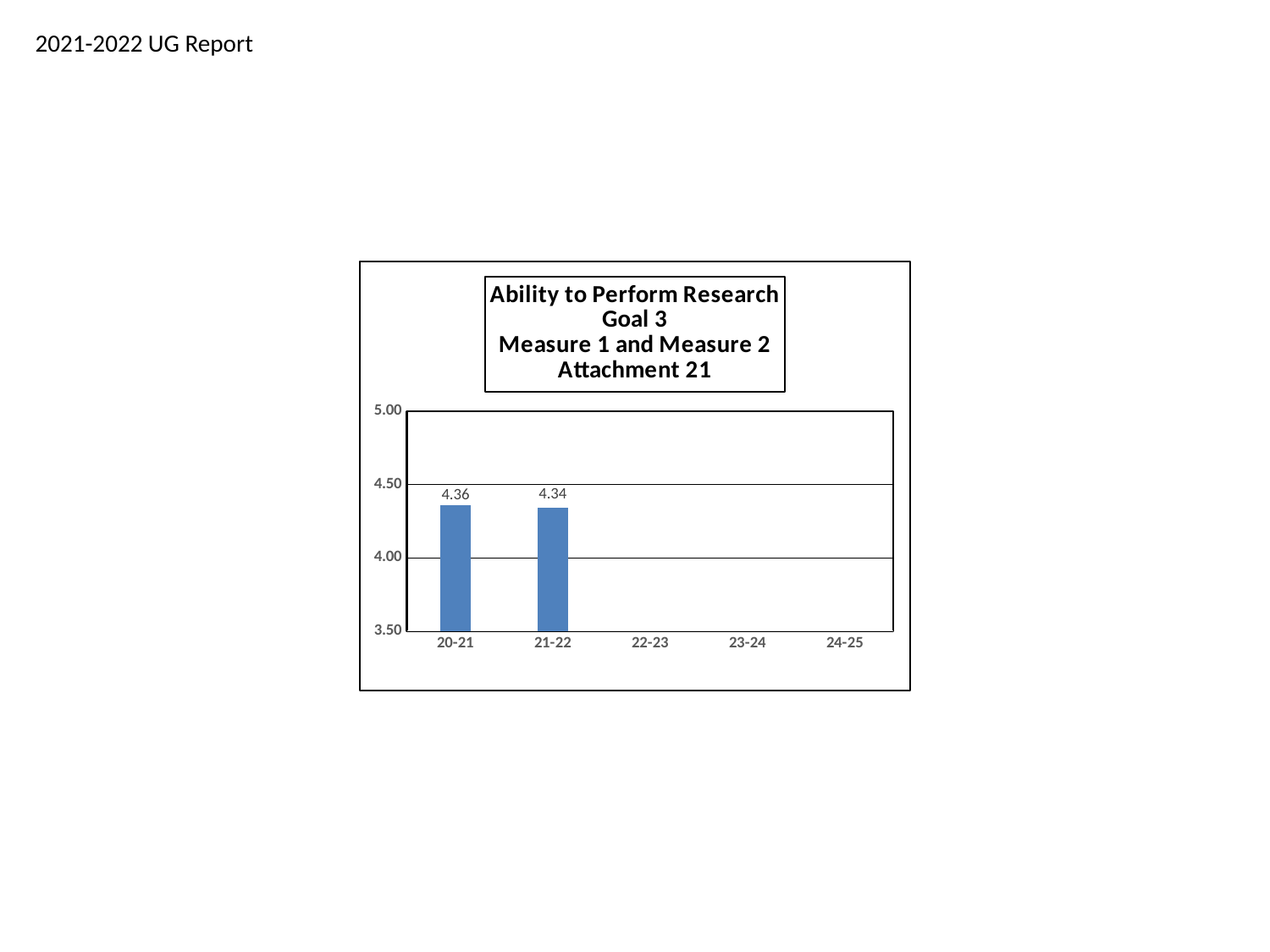
What is the difference between the values for 20-21 and 21-22? 0.02 Do the values rise or fall from 20-21 to 21-22? fall Which is larger, the value for 20-21 or the value for 21-22? 20-21 How many categories are shown on the x axis? 5 What is the value for 21-22? 4.34 Is the value for 21-22 greater or less than 4.00? greater Is the value for 20-21 greater or less than 4.50? less Which category has the highest value? 20-21 How many categories have a plotted bar? 2 What is the value for 20-21? 4.36 What is the first line of the chart title? Ability to Perform Research What kind of chart is shown? bar chart